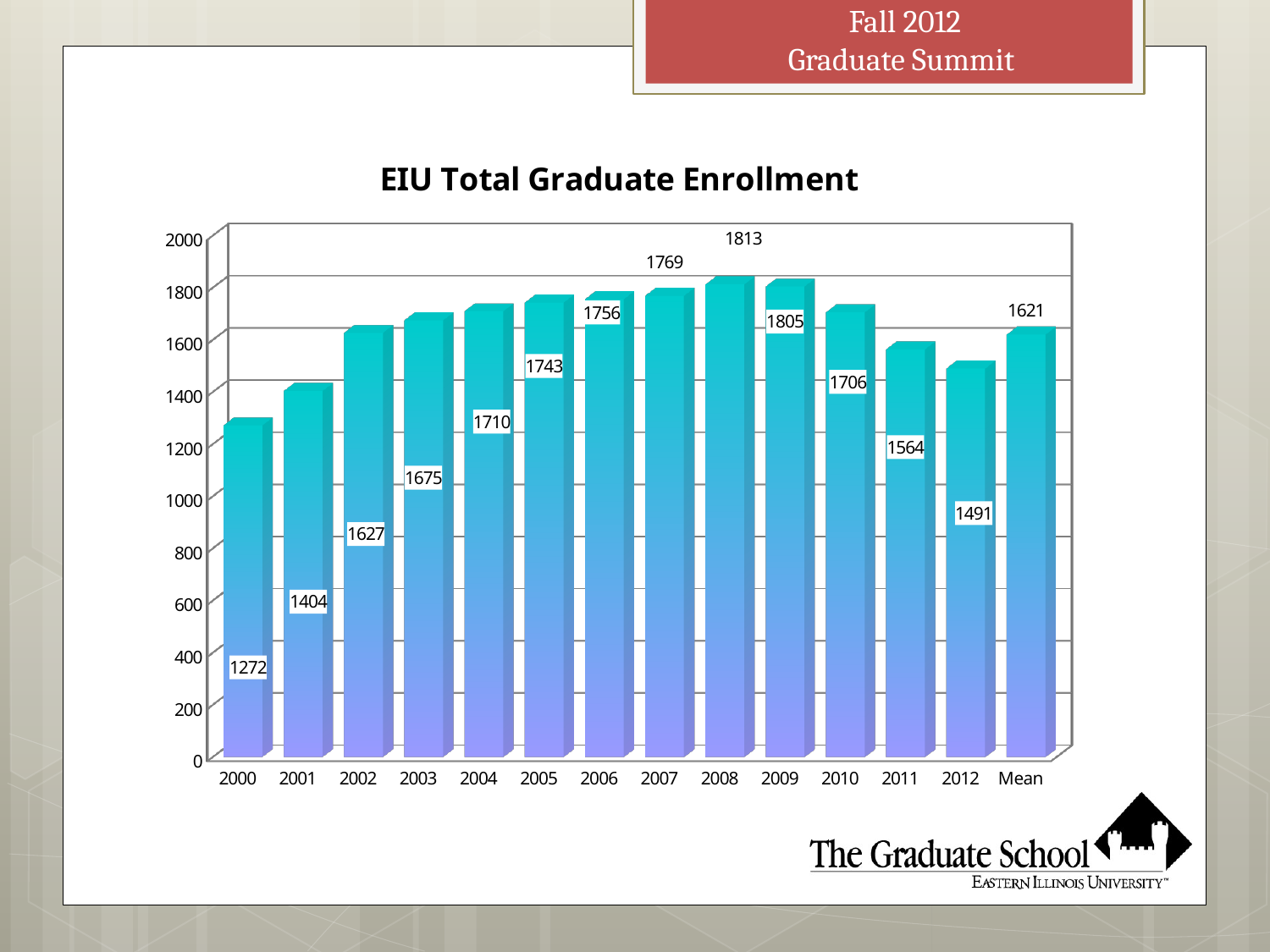
Which year has the lowest total graduate enrollment? 2000 Do the enrollment values rise or fall from 2000 to 2008? rise How many bars are shown in the chart? 14 What is the difference in enrollment between 2008 and 2012? 322 What is the total graduate enrollment for 2000? 1272 What is the title of the chart? EIU Total Graduate Enrollment What kind of chart is shown on the slide? bar chart What value is shown for the Mean bar? 1621 What is the total graduate enrollment for 2008? 1813 Which year has the highest total graduate enrollment? 2008 Is the value for 2012 greater or less than 1600? less Which year had higher enrollment, 2004 or 2011? 2004